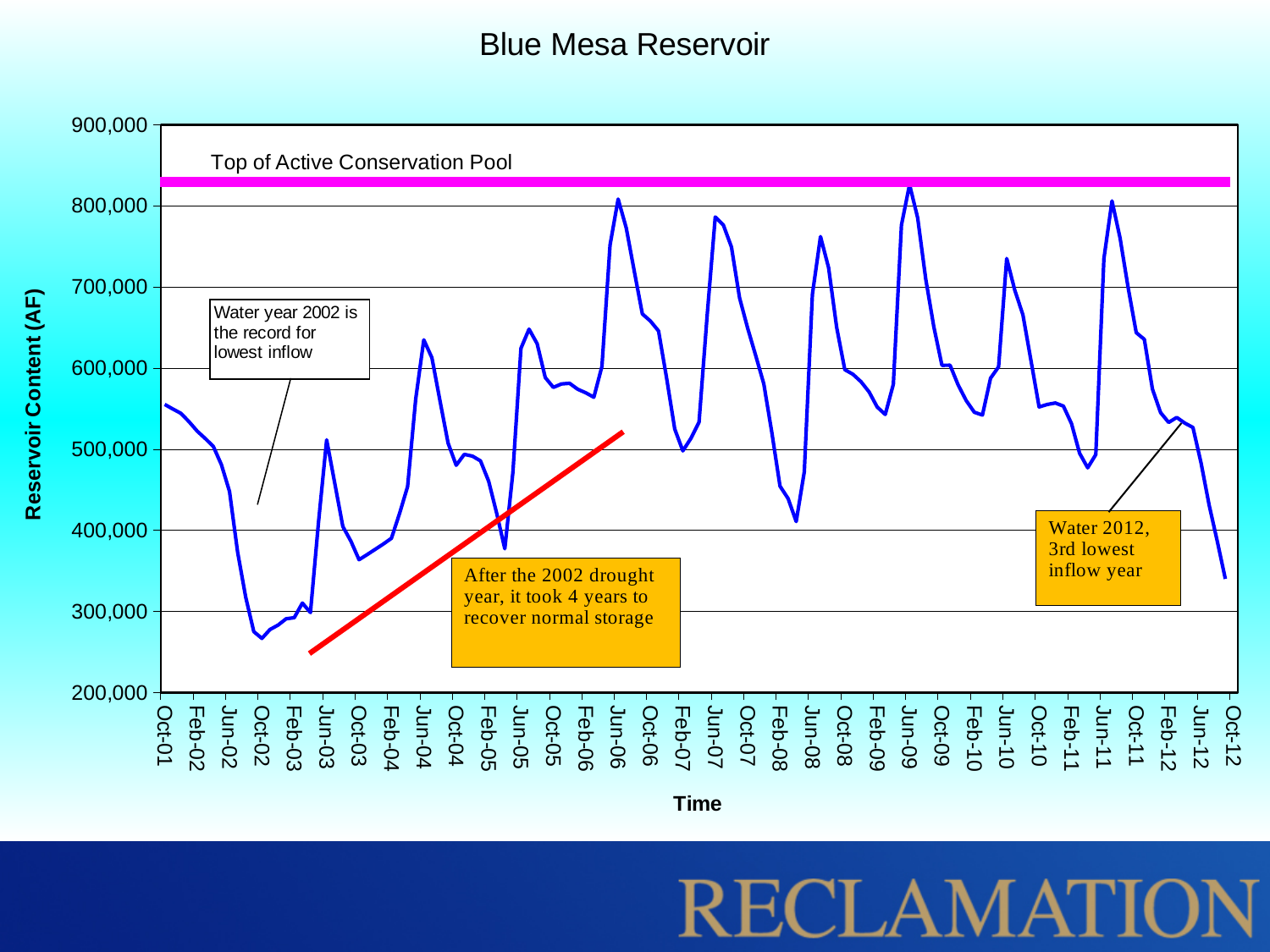
Is the reservoir content at Oct-12 greater or less than 400,000? less Which is larger, the peak reservoir content around Jun-09 or the peak around Jun-04? Jun-09 What kind of chart is shown on the slide? Line chart Around which x-axis label does the reservoir content reach its highest point? Jun-09 Around which x-axis label does the reservoir content reach its lowest point? Oct-02 Is the reservoir content at Oct-02 greater or less than 300,000? less Is the reservoir content at Oct-01 greater or less than 500,000? greater What is the title of the chart? Blue Mesa Reservoir What is the label on the vertical axis of the chart? Reservoir Content (AF) Does the reservoir content rise or fall between Oct-01 and Oct-02? fall